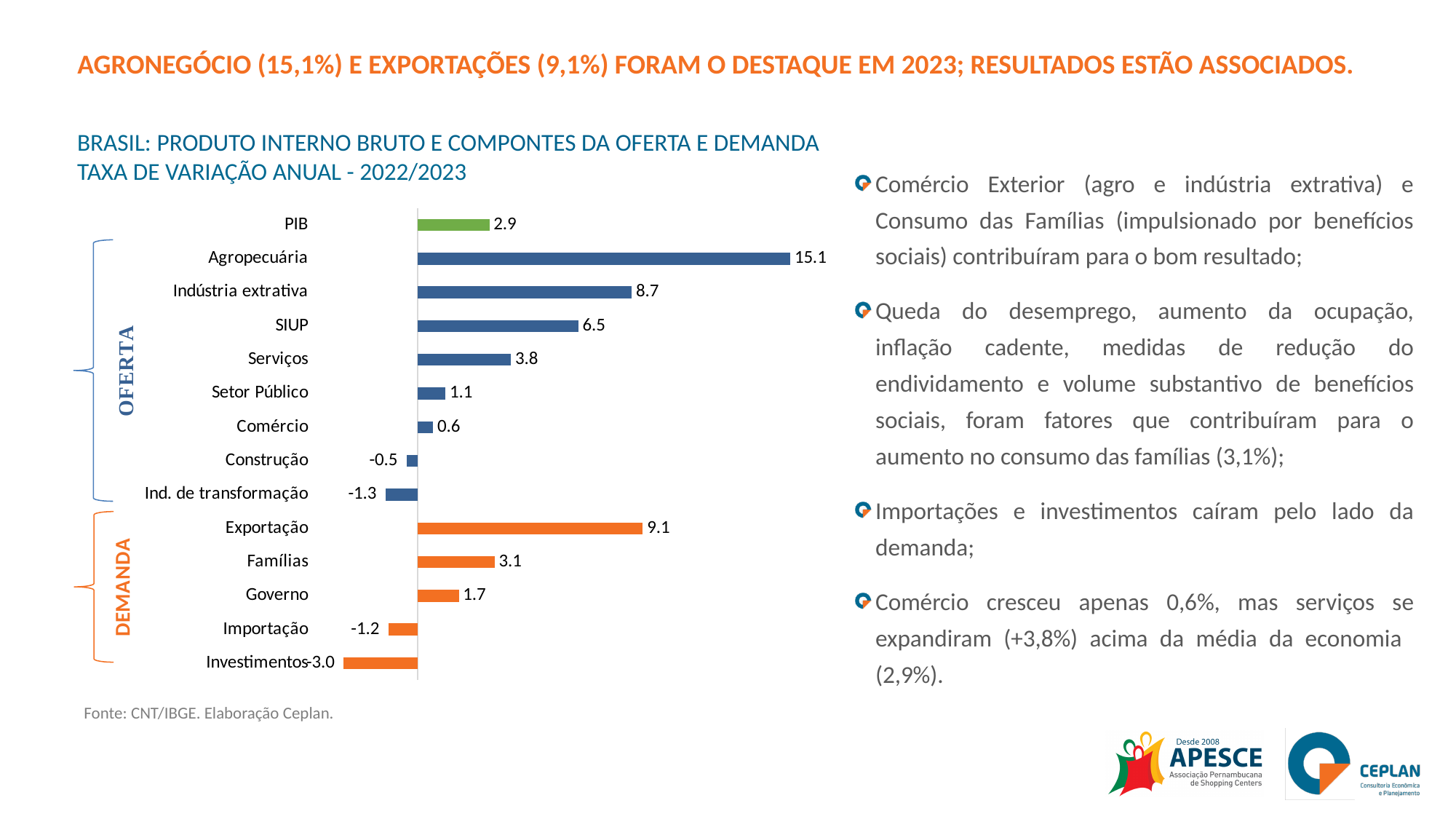
What is the value shown for Exportação? 9.1 What is the difference between the values for Agropecuária and Indústria extrativa? 6.4 What is the value shown for Investimentos? -3.0 Which category has the lowest value in the chart? Investimentos What is the value shown for Agropecuária? 15.1 What is the value shown for PIB? 2.9 What kind of chart is shown on the slide? Bar chart How many categories are plotted in the chart? 14 Which category has the highest value in the chart? Agropecuária What is the source cited below the chart? CNT/IBGE. Elaboração Ceplan. What is the difference between the values for Exportação and Famílias? 6.0 Which is larger, the value for Serviços or the value for Comércio? Serviços